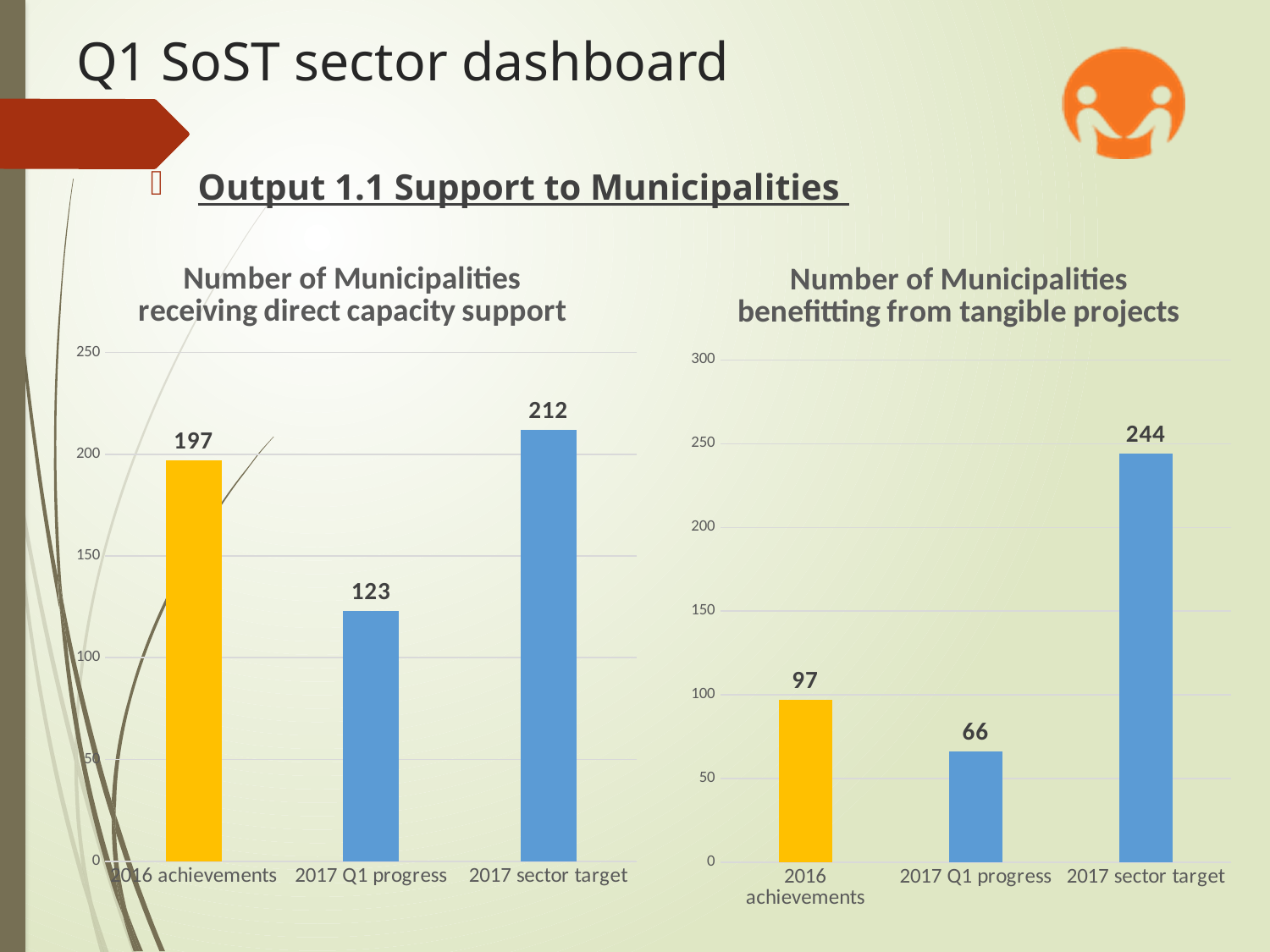
In the 'Number of Municipalities benefitting from tangible projects' chart, what is the value for 2017 Q1 progress? 66 In the 'Number of Municipalities benefitting from tangible projects' chart, what is the difference between 2016 achievements and 2017 Q1 progress? 31 In the 'Number of Municipalities receiving direct capacity support' chart, what is the value for 2017 Q1 progress? 123 In the 'Number of Municipalities receiving direct capacity support' chart, what is the difference between the 2017 sector target and the 2017 Q1 progress? 89 In the 'Number of Municipalities benefitting from tangible projects' chart, which category has the lowest value? 2017 Q1 progress What kind of chart is the 'Number of Municipalities benefitting from tangible projects' chart? Bar chart In the 'Number of Municipalities receiving direct capacity support' chart, which category has the highest value? 2017 sector target In the 'Number of Municipalities benefitting from tangible projects' chart, which is larger: 2016 achievements or 2017 Q1 progress? 2016 achievements In the 'Number of Municipalities receiving direct capacity support' chart, what is the value for 2016 achievements? 197 In the 'Number of Municipalities receiving direct capacity support' chart, what colour is the 2016 achievements bar? Yellow In the 'Number of Municipalities benefitting from tangible projects' chart, what is the value for 2017 sector target? 244 How many categories are shown in the 'Number of Municipalities receiving direct capacity support' chart? 3